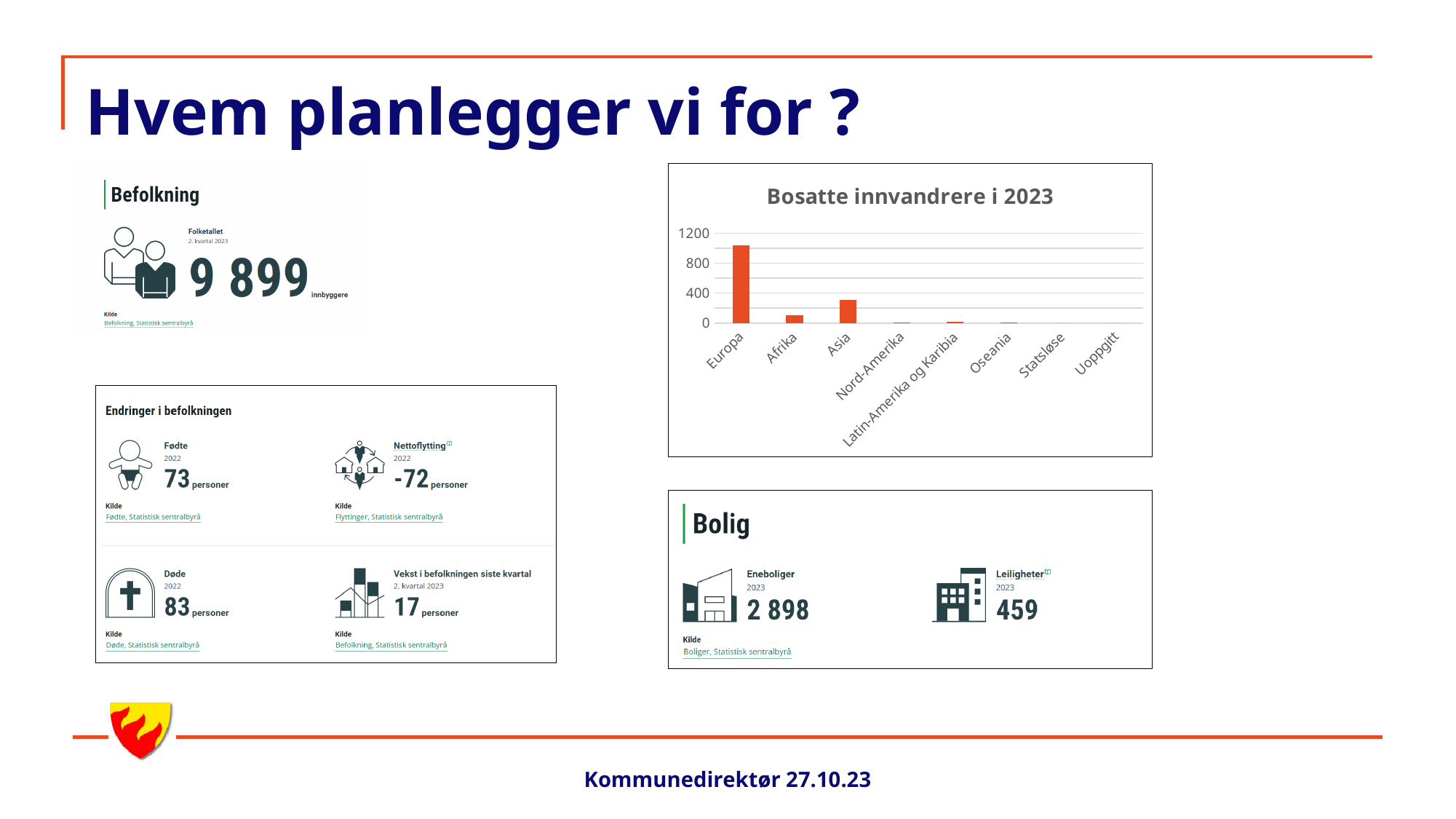
In the 'Bosatte innvandrere i 2023' chart, is the value for Afrika greater or less than 400? less In the 'Bosatte innvandrere i 2023' chart, which is larger, the value for Afrika or the value for Oseania? Afrika In the 'Bosatte innvandrere i 2023' chart, is the value for Europa greater or less than 800? greater In the 'Bosatte innvandrere i 2023' chart, is the value for Europa greater or less than 1200? less In the 'Bosatte innvandrere i 2023' chart, which is larger, the value for Europa or the value for Asia? Europa In the 'Bosatte innvandrere i 2023' chart, which category has the highest value? Europa What kind of chart is 'Bosatte innvandrere i 2023'? bar chart How many categories are shown on the x axis of the 'Bosatte innvandrere i 2023' chart? 8 In the 'Bosatte innvandrere i 2023' chart, which is larger, the value for Asia or the value for Afrika? Asia What is the title of the bar chart on the slide? Bosatte innvandrere i 2023 What colour are the bars in the 'Bosatte innvandrere i 2023' chart? orange-red